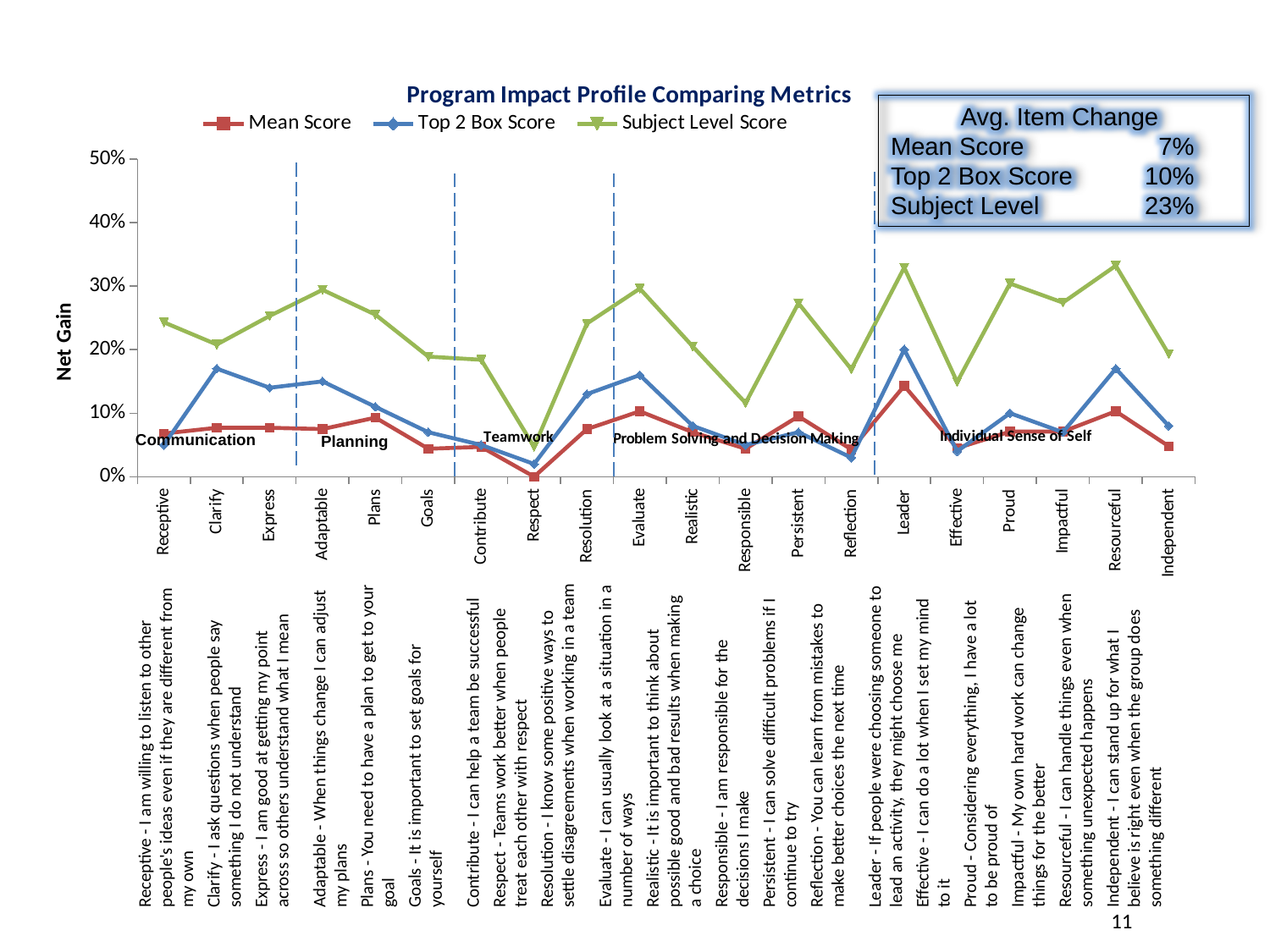
How many series does the legend list? 3 Which is larger for Clarify: the Top 2 Box Score or the Mean Score? Top 2 Box Score Is the Top 2 Box Score for Respect greater or less than 10%? less How many categories are plotted along the x axis? 20 According to the Avg. Item Change box, what is the average item change for Subject Level? 23% What kind of chart is shown on the slide? Line chart Which category has the highest Mean Score? Leader Is the Subject Level Score for Leader greater or less than 30%? greater Which category has the highest Top 2 Box Score? Leader Which category has the lowest Subject Level Score? Respect Does the Subject Level Score rise or fall from Respect to Evaluate? Rise What is the title of the chart? Program Impact Profile Comparing Metrics